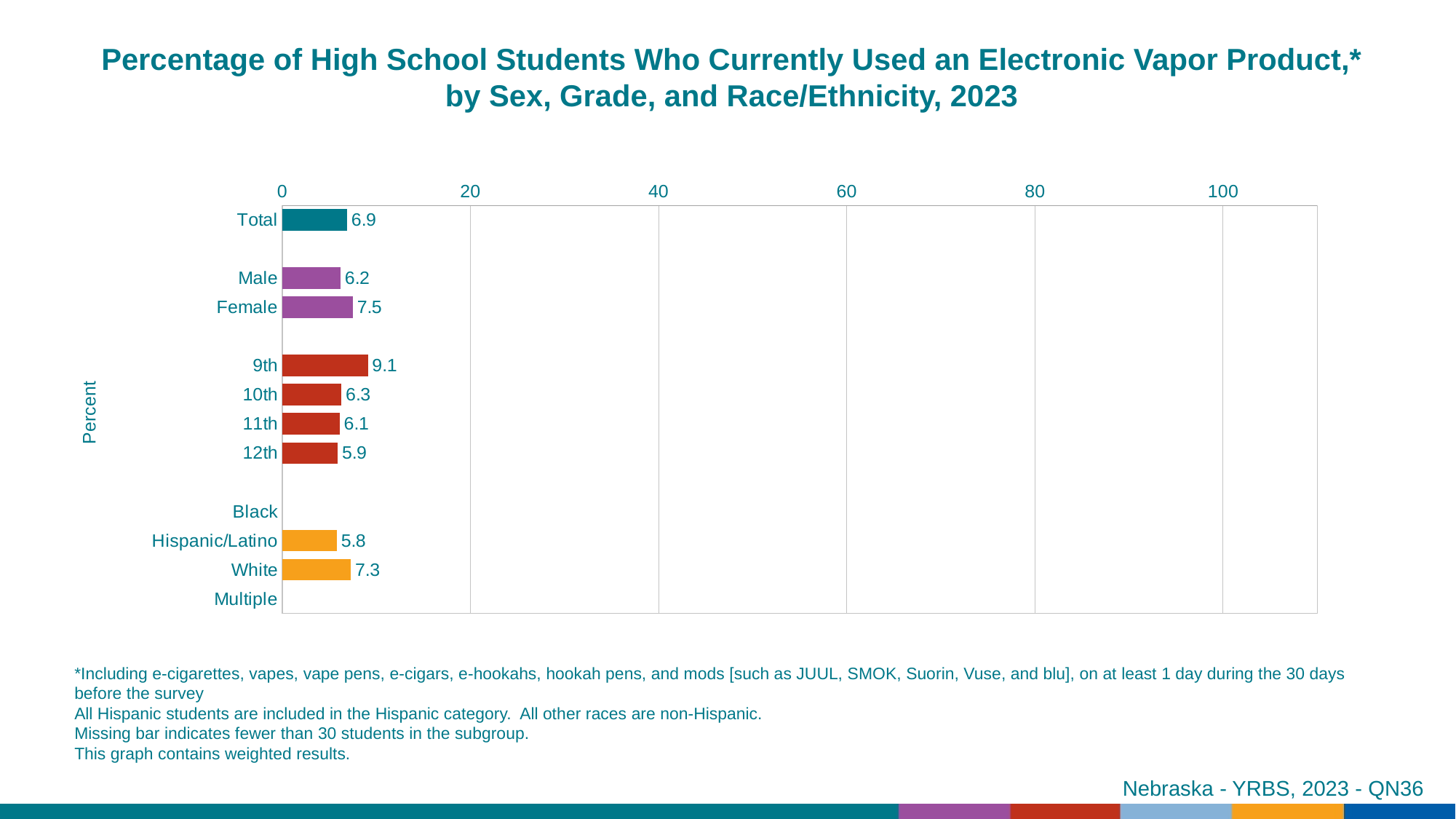
Which categories have no bar shown? Black and Multiple What is the difference between the 9th and 12th grade values? 3.2 What kind of chart is shown on the slide? bar chart Which category has the highest value? 9th Is the value for Total greater or less than 20? less What is the value for Hispanic/Latino? 5.8 What is the difference between the Female and Male values? 1.3 Among the grade categories, which has the lowest value? 12th What is the value for Female? 7.5 What is the value for Total? 6.9 Which is larger, the value for White or the value for Hispanic/Latino? White What is the value for 9th grade? 9.1